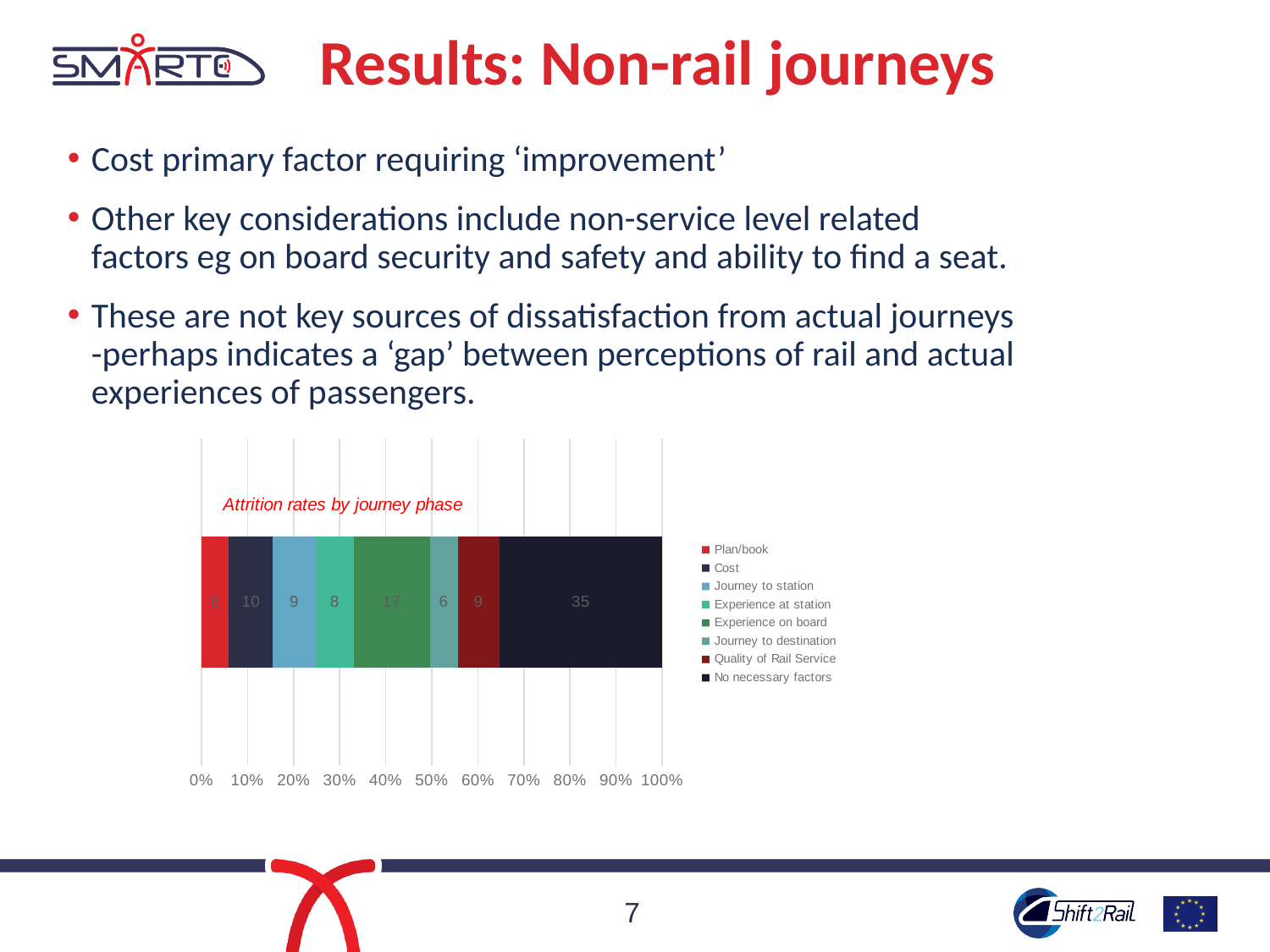
What value is shown for the Experience on board segment in the Attrition rates by journey phase chart? 17 What kind of chart is shown on the slide? Stacked bar chart How many series does the legend list? 8 What value is shown for the No necessary factors segment? 35 Which segment has the largest value in the stacked bar? No necessary factors What is the total of all segments in the stacked bar? 100 What value is shown for the Quality of Rail Service segment? 9 What value is shown for the Experience at station segment? 8 What is the title of the chart? Attrition rates by journey phase Which is larger, the Cost value or the Journey to station value? Cost What is the difference between the No necessary factors value and the Experience on board value? 18 What value is shown for the Cost segment? 10